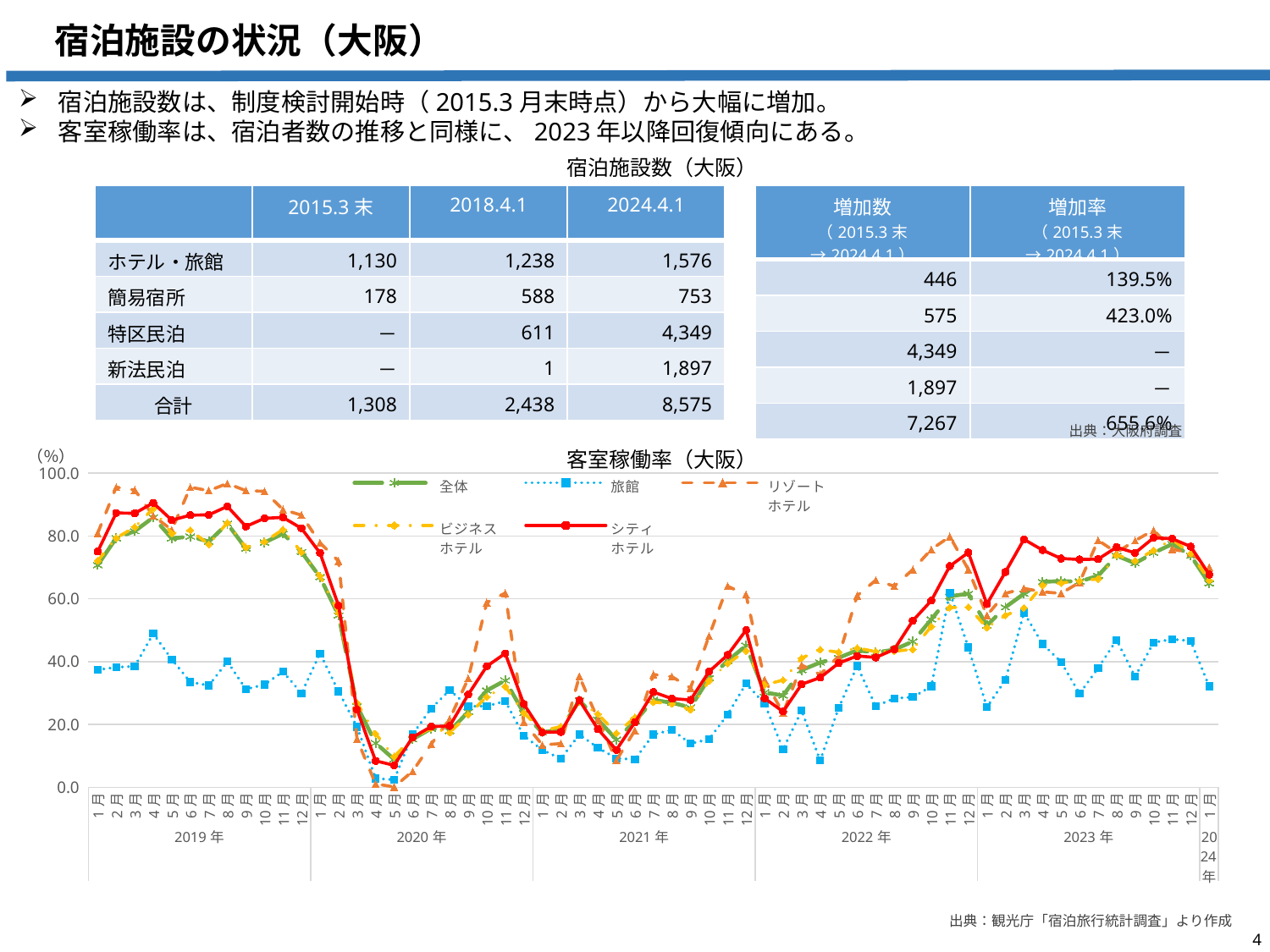
In the 客室稼働率（大阪） chart, which series is drawn as a solid red line with circle markers? シティホテル In the 客室稼働率（大阪） chart, which series has the lowest value in 2019年1月? 旅館 In the 客室稼働率（大阪） chart, is the value for 旅館 in 2023年1月 greater or less than 40.0? less In the 客室稼働率（大阪） chart, does the 全体 line rise or fall from 2022年1月 to 2022年12月? rise What kind of chart is the 客室稼働率（大阪） chart? line chart In the 客室稼働率（大阪） chart, which is larger in 2019年1月: シティホテル or 旅館? シティホテル In the 客室稼働率（大阪） chart, is the value for シティホテル in 2019年4月 greater or less than 80.0? greater In the 客室稼働率（大阪） chart, is the value for シティホテル in 2023年3月 greater or less than 60.0? greater How many series does the legend of the 客室稼働率（大阪） chart list? 5 What unit is shown on the y axis of the 客室稼働率（大阪） chart? % In the 客室稼働率（大阪） chart, does the シティホテル line rise or fall from 2020年1月 to 2020年5月? fall